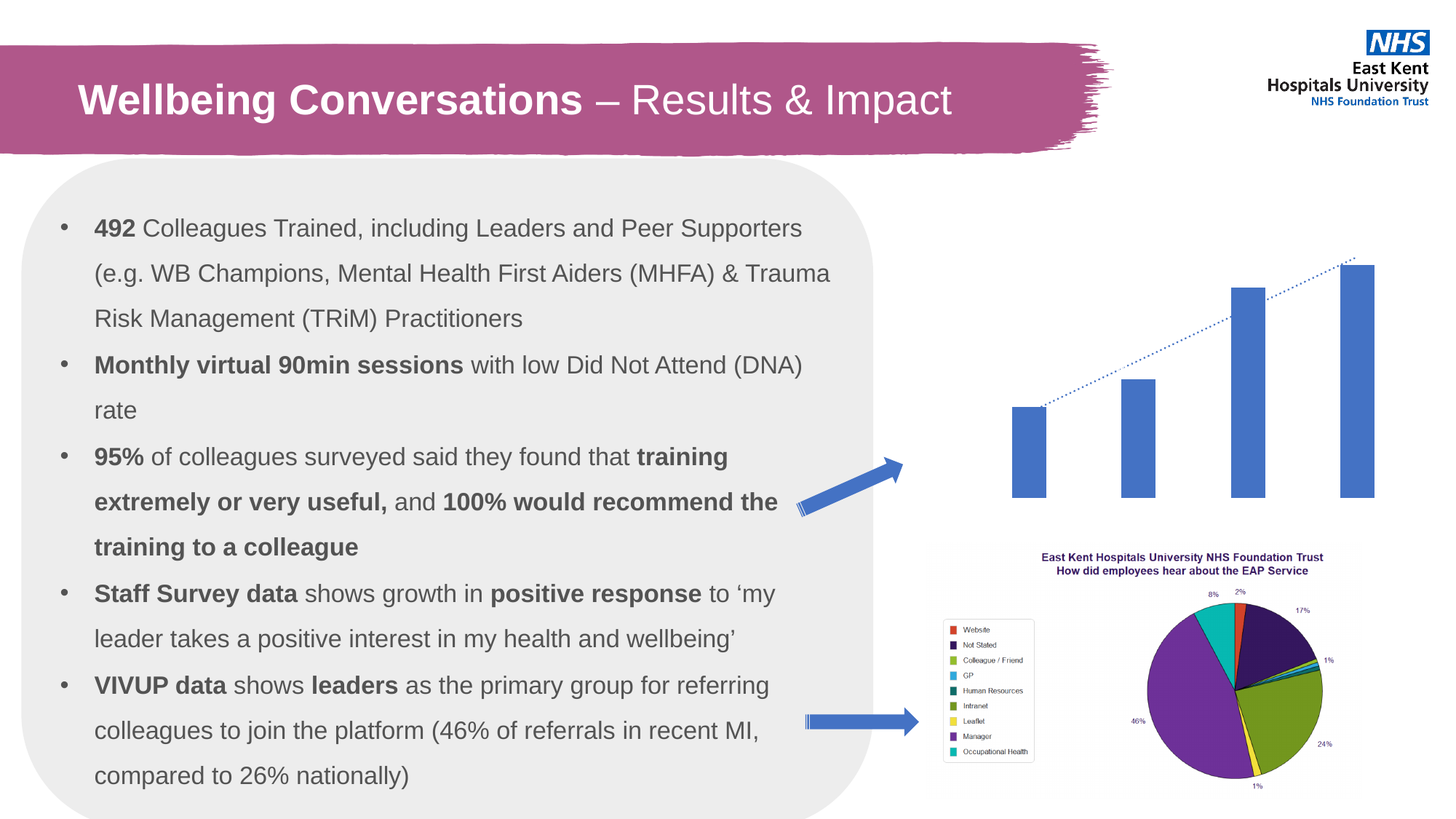
In the upper bar chart on the right, which bar is the tallest? the rightmost (fourth) bar In the pie chart 'How did employees hear about the EAP Service', what is the difference between the Manager share and the Colleague / Friend share? 22% In the pie chart 'How did employees hear about the EAP Service', which category has the largest share? Manager In the upper bar chart on the right, is the first bar or the last bar taller? the last bar In the upper bar chart on the right, do the bar values rise or fall from left to right? rise In the pie chart 'How did employees hear about the EAP Service', how many entries does the legend list? 9 How many bars does the upper bar chart on the right show? 4 In the pie chart 'How did employees hear about the EAP Service', what share is Colleague / Friend? 24% In the pie chart 'How did employees hear about the EAP Service', which is larger: Not Stated or Occupational Health? Not Stated What kind of chart is the lower chart titled 'How did employees hear about the EAP Service'? pie chart In the pie chart 'How did employees hear about the EAP Service', what share is Manager? 46% What kind of chart is the upper chart on the right of the slide? bar chart